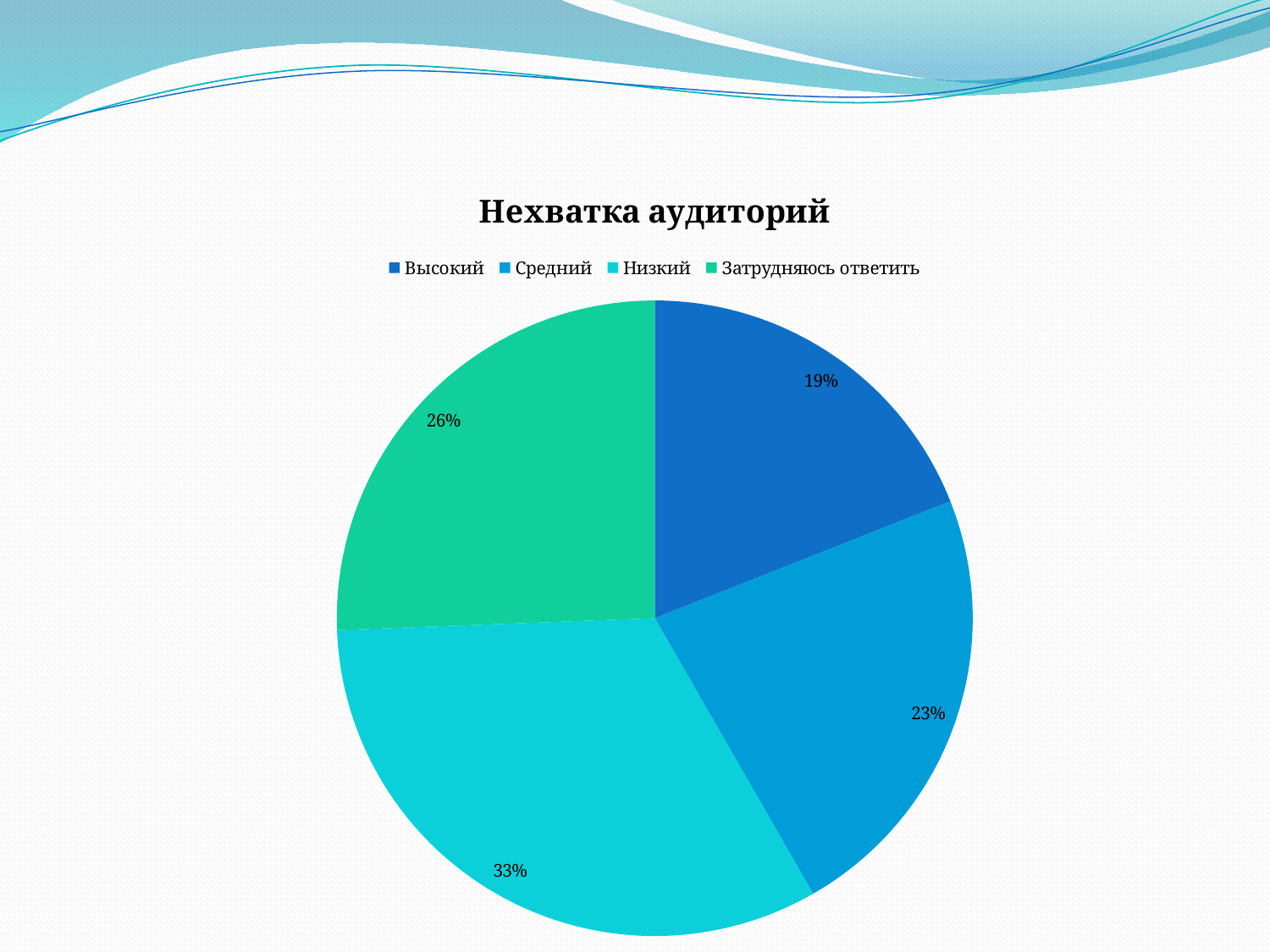
What is the difference between the "Затрудняюсь ответить" and "Средний" shares? 3% Which category has the smallest slice of the pie? Высокий What is the title of the chart? Нехватка аудиторий What is the value shown for "Затрудняюсь ответить"? 26% What kind of chart is shown on the slide? Pie chart Which category has the largest slice of the pie? Низкий What is the difference between the "Низкий" and "Высокий" shares? 14% What share of the pie does the "Низкий" slice represent? 33% What is the value shown for "Средний"? 23% How many slices does the pie chart have? 4 What is the value shown for "Высокий"? 19% Which is larger, the share for "Средний" or the share for "Затрудняюсь ответить"? Затрудняюсь ответить